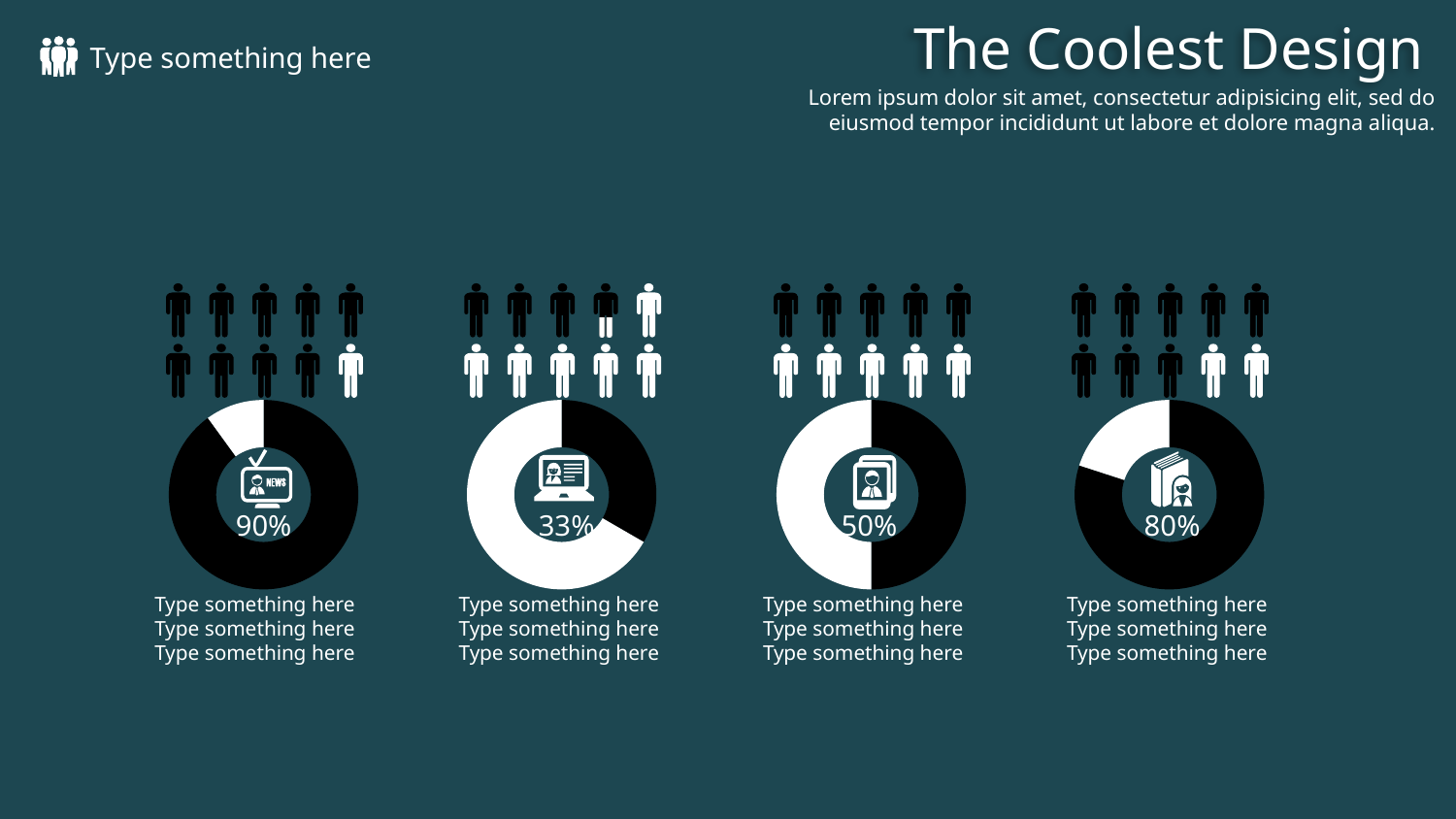
What is the title of the slide? The Coolest Design What is the difference between the percentage in the leftmost donut chart and the percentage in the rightmost donut chart? 10% What is the difference between the percentage in the third donut chart and the percentage in the second donut chart? 17% What percentage is shown in the third donut chart from the left (with the photo icon)? 50% Which is larger: the percentage in the second donut chart from the left or the percentage in the third donut chart from the left? The third chart (50%) What percentage is shown in the second donut chart from the left (with the laptop icon)? 33% How many donut charts are shown on the slide? 4 Which of the four donut charts shows the highest percentage? The leftmost chart (90%) What percentage is shown in the leftmost donut chart (with the TV news icon)? 90% What percentage is shown in the rightmost donut chart (with the book icon)? 80% What kind of chart is used to display the percentages on the slide? Donut (pie) chart Which of the four donut charts shows the lowest percentage? The second chart from the left (33%)